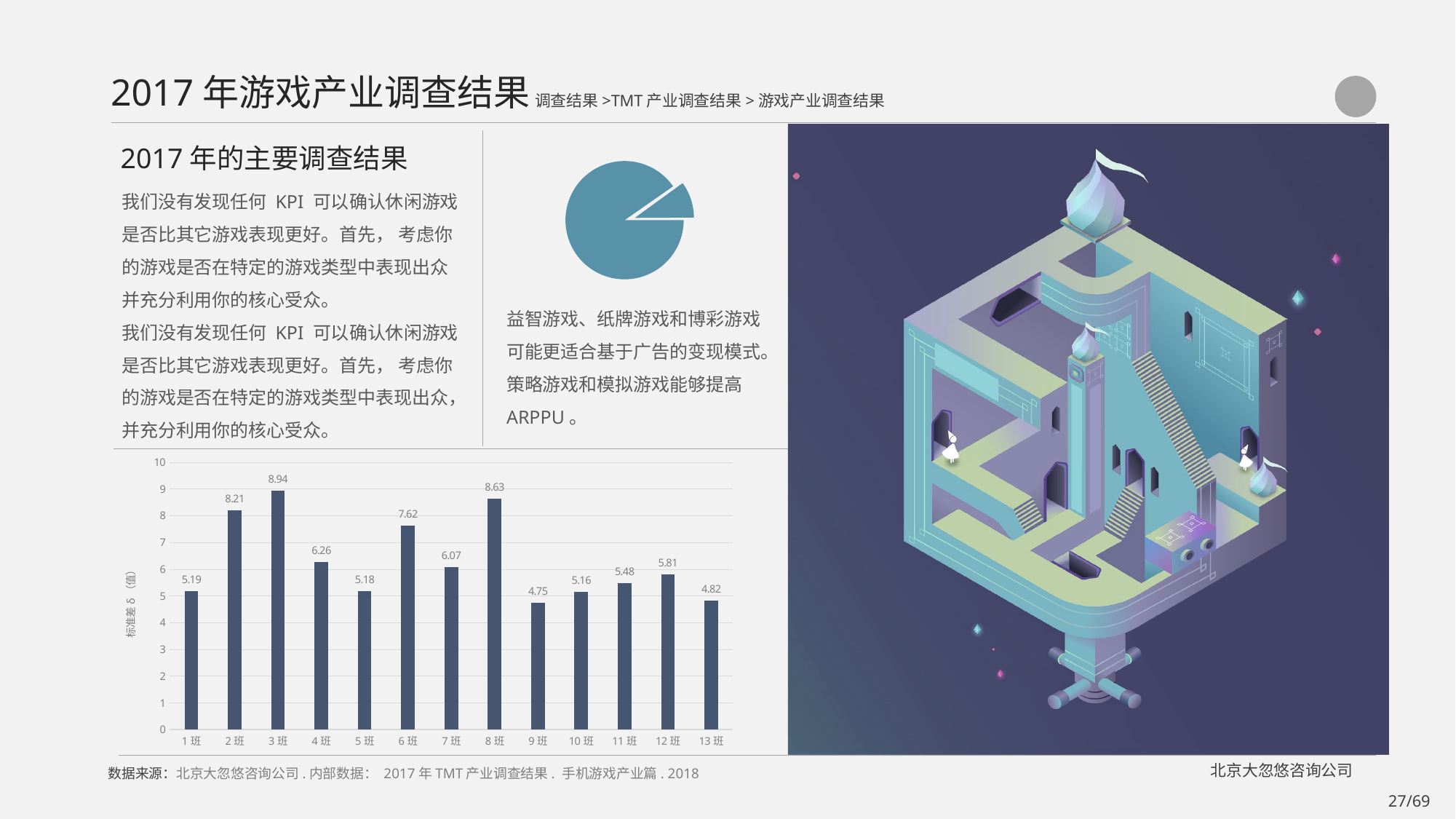
In the bar chart at the bottom left, what is the difference between the values for 3班 and 9班? 4.19 What kind of chart is shown at the bottom left of the slide? bar chart In the bar chart at the bottom left, which category has the lowest value? 9班 How many categories are shown on the x axis of the bar chart at the bottom left? 13 In the bar chart at the bottom left, which is larger, the value for 6班 or the value for 7班? 6班 In the bar chart at the bottom left, what is the difference between the values for 2班 and 4班? 1.95 What is the y-axis label of the bar chart at the bottom left? 标准差δ（值） In the bar chart at the bottom left, what is the value for 12班? 5.81 In the bar chart at the bottom left, what is the value for 9班? 4.75 In the bar chart at the bottom left, which category has the highest value? 3班 In the bar chart at the bottom left, what is the value for 3班? 8.94 In the bar chart at the bottom left, is the value for 8班 greater or less than 8? greater